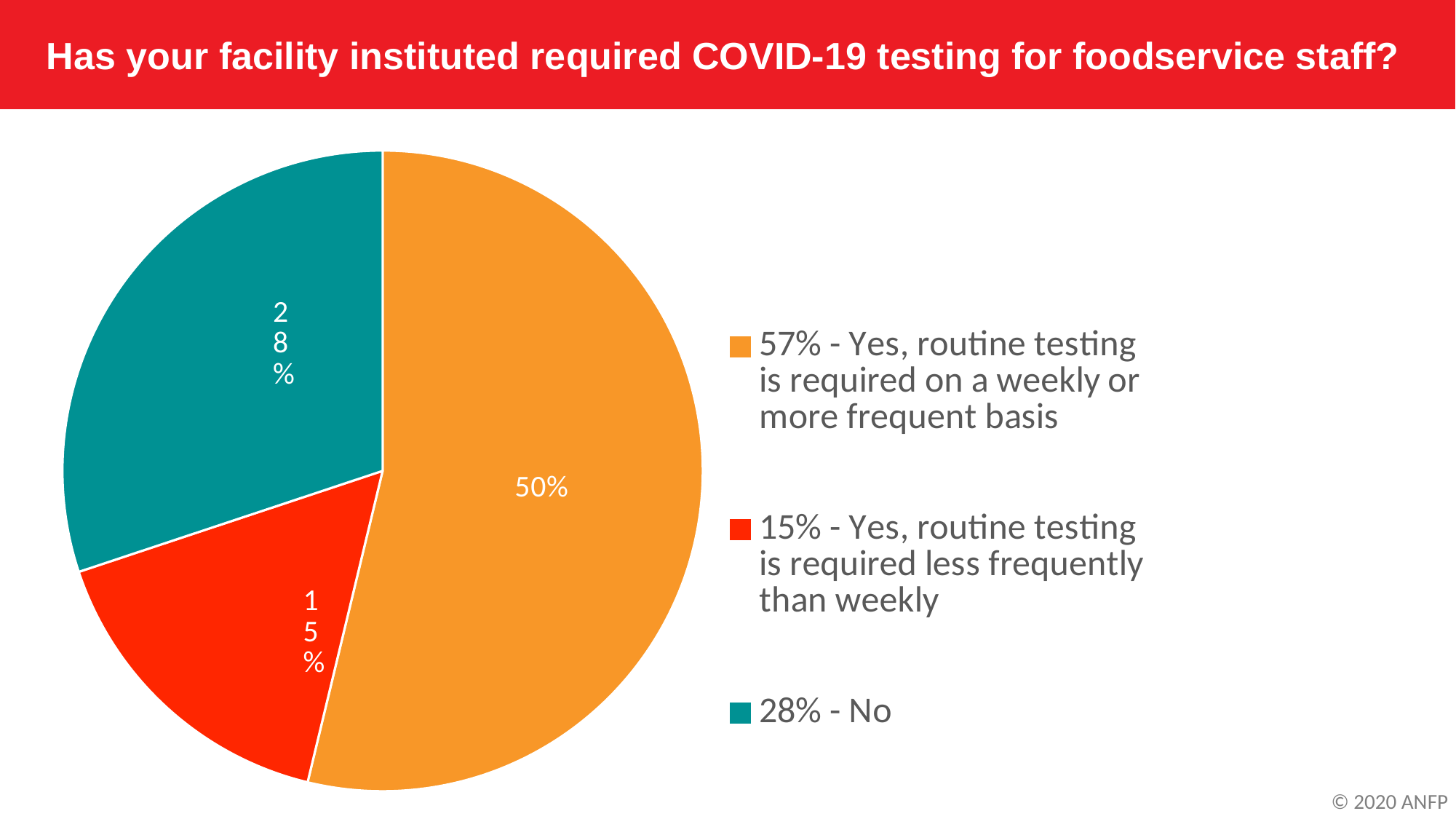
What percentage is printed on the 'No' slice of the pie chart? 28% What percentage label is printed on the orange slice of the pie chart? 50% What colour is the 'No' slice in the pie chart? Teal Which slice is larger: 'No' or 'Yes, routine testing is required less frequently than weekly'? No Which response has the smallest slice of the pie chart? Yes, routine testing is required less frequently than weekly Which response has the largest slice of the pie chart? Yes, routine testing is required on a weekly or more frequent basis What is the difference in percentage points between the 'No' slice (28%) and the 'less frequently than weekly' slice (15%)? 13 percentage points How many slices does the pie chart have? 3 What percentage is printed on the slice for 'Yes, routine testing is required less frequently than weekly'? 15% What kind of chart is shown on the slide? Pie chart What is the title of the slide? Has your facility instituted required COVID-19 testing for foodservice staff? How many entries does the legend list? 3